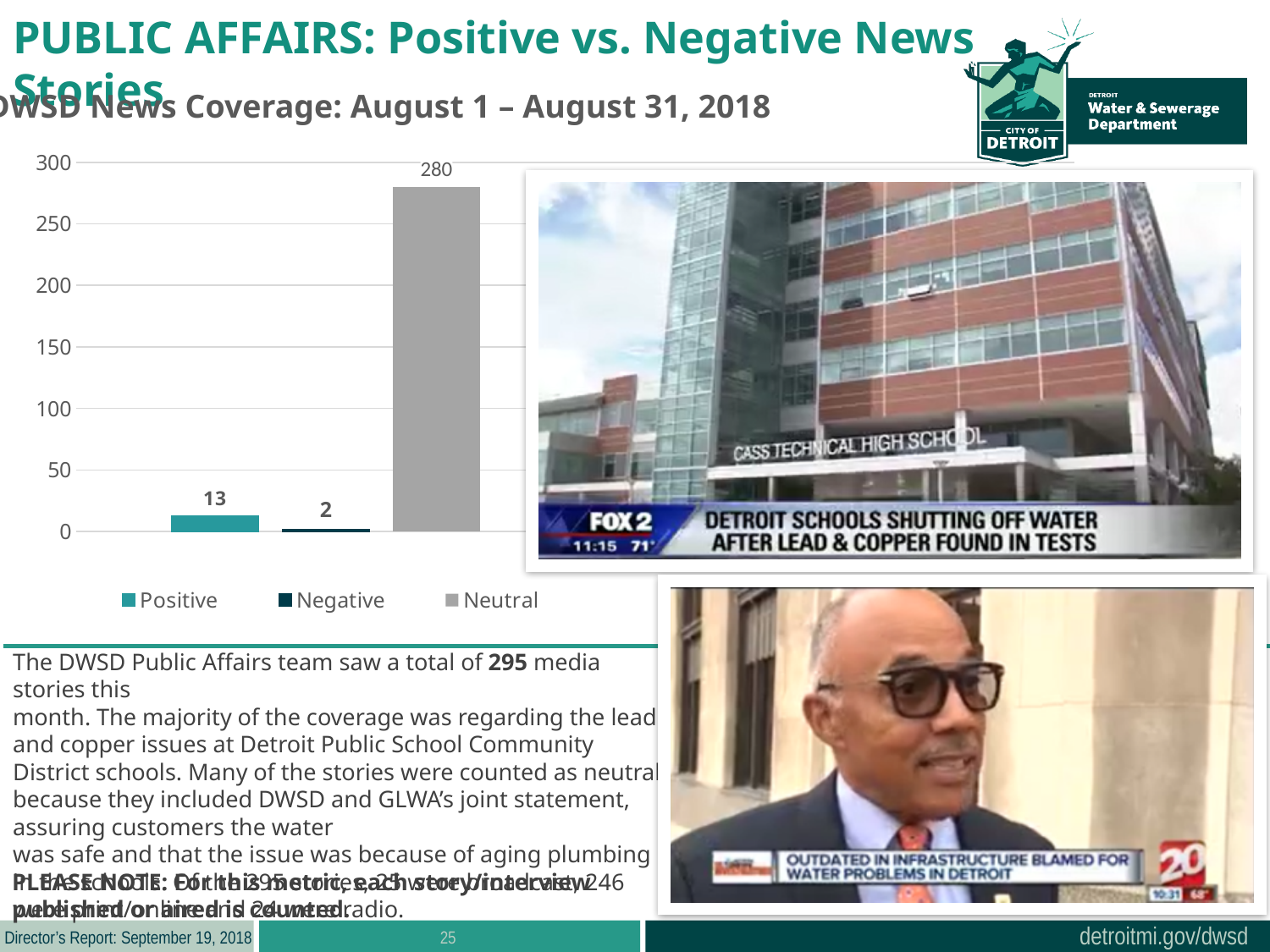
What is the difference between the Positive and Negative values? 11 What is the difference between the Neutral and Positive values? 267 What is the value for Negative news stories? 2 Is the value for Neutral greater or less than 250? greater What is the value for Positive news stories? 13 What is the value for Neutral news stories? 280 What colour is the Positive bar? Teal Which is larger, the value for Positive or the value for Negative? Positive Which category has the highest value? Neutral Which category has the lowest value? Negative What kind of chart is shown on the slide? Bar chart How many series does the legend list? 3